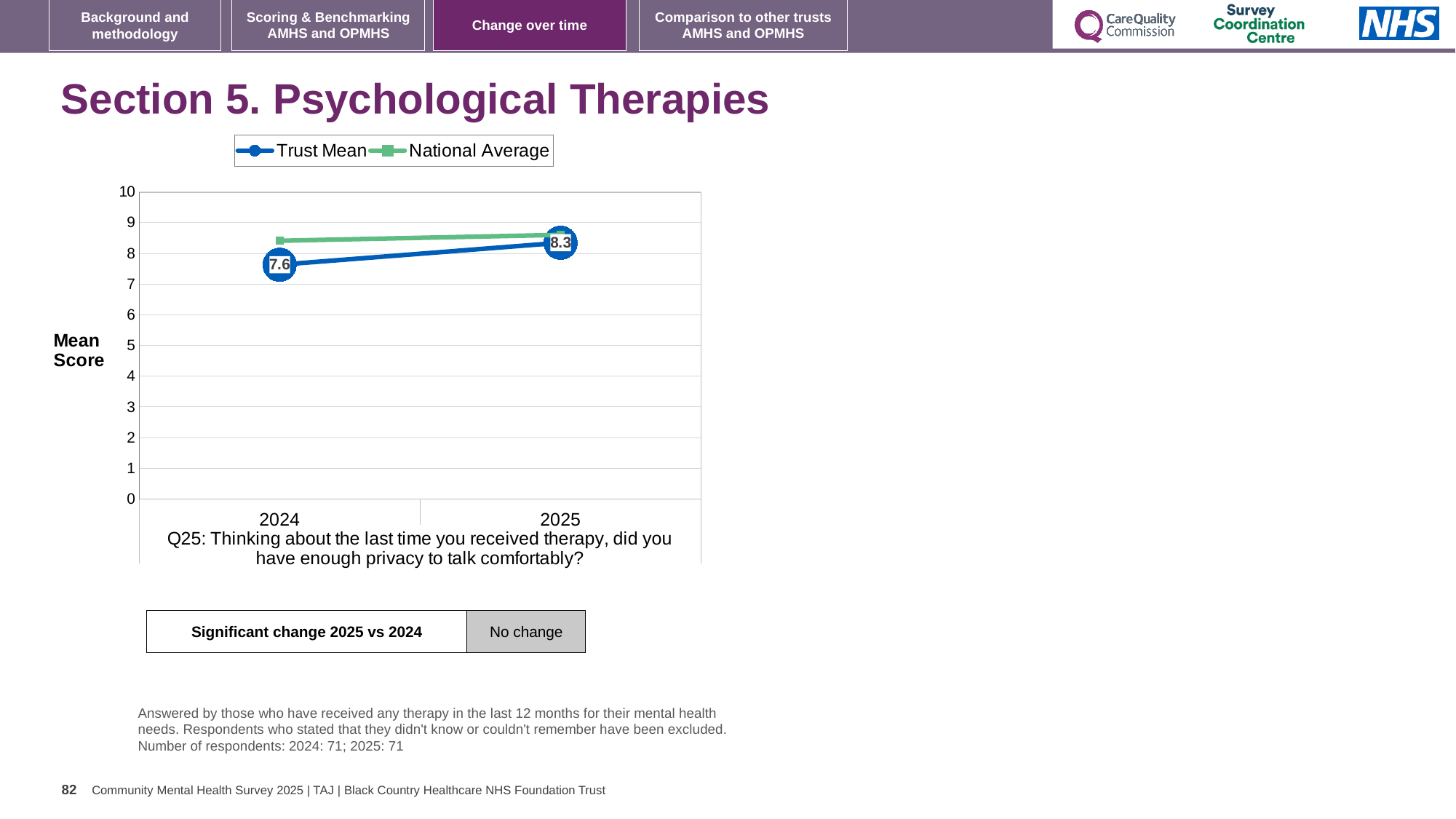
Does the Trust Mean rise or fall from 2024 to 2025? rise In which year is the Trust Mean higher? 2025 In 2024, which is larger: the Trust Mean or the National Average? National Average Is the National Average value for 2025 greater or less than 9? less How many years are shown on the x axis of the chart? 2 What is the Trust Mean value for 2025? 8.3 What is the Trust Mean value for 2024? 7.6 Is the National Average value for 2024 greater or less than 8? greater What is the label on the y axis of the chart? Mean Score By how much did the Trust Mean change from 2024 to 2025? 0.7 How many series does the chart legend list? 2 What kind of chart is shown on the slide? line chart